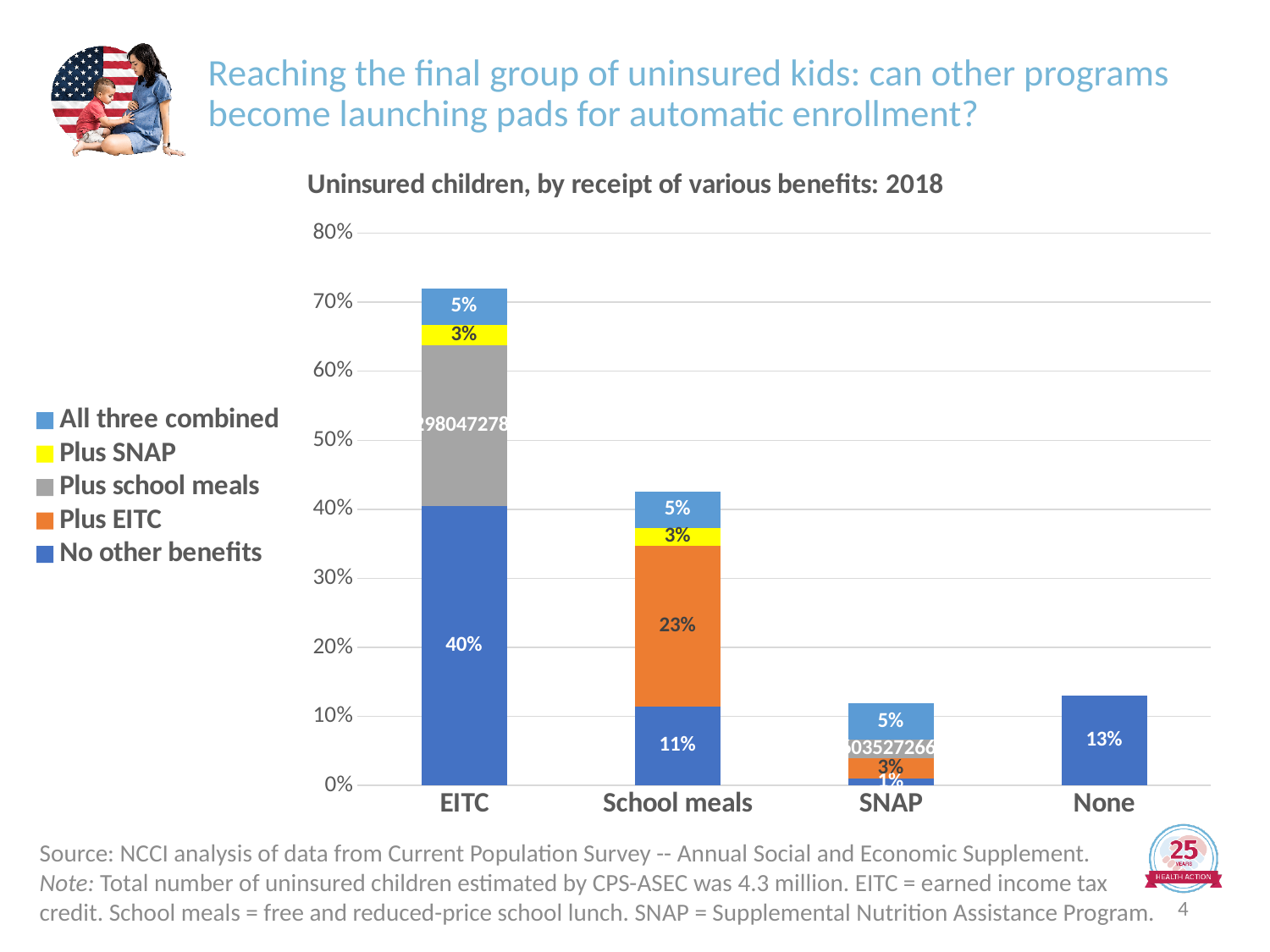
How many categories are shown on the x axis? 4 What is the value of the 'No other benefits' segment for EITC? 40% What is the difference between the 'No other benefits' segments for EITC and School meals? 29% What is the total of the stacked bar for School meals? 42% What kind of chart is shown on the slide? Stacked bar chart What is the value of the 'No other benefits' segment for School meals? 11% What is the value of the 'All three combined' segment for SNAP? 5% What is the value shown for the None category? 13% Which category has the tallest stacked bar overall? EITC What is the value of the 'Plus EITC' segment for School meals? 23% How many series does the legend list? 5 Is the total height of the EITC bar greater or less than 60%? greater